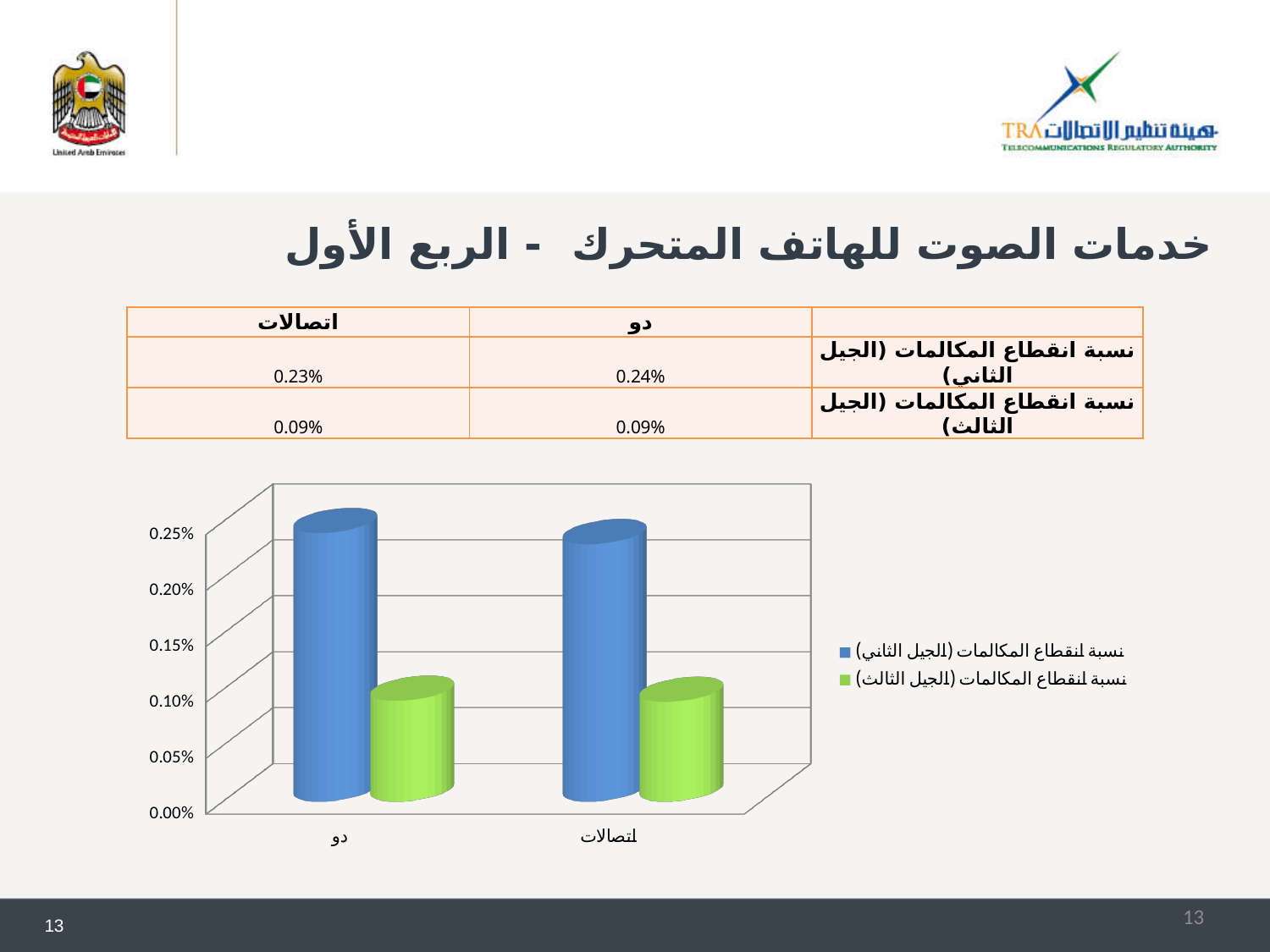
According to the slide, what is the call drop rate for the second generation (الجيل الثاني) for دو? 0.24% What is the difference between the second generation and third generation call drop rates for دو? 0.15% According to the slide, what is the call drop rate for the second generation (الجيل الثاني) for اتصالات? 0.23% For دو, which series is larger in the chart: the second generation (الجيل الثاني) or the third generation (الجيل الثالث) call drop rate? الجيل الثاني According to the slide, what is the call drop rate for the third generation (الجيل الثالث) for اتصالات? 0.09% How many categories (operators) are shown on the x axis of the chart? 2 Is the second generation (الجيل الثاني) call drop rate for دو greater or less than 0.20%? greater What type of chart is shown on the slide? bar chart Is the third generation (الجيل الثالث) call drop rate for اتصالات greater or less than 0.15%? less What is the difference between the second generation and third generation call drop rates for اتصالات? 0.14% Which colour represents the third generation (الجيل الثالث) series in the chart? green How many series does the chart legend list? 2